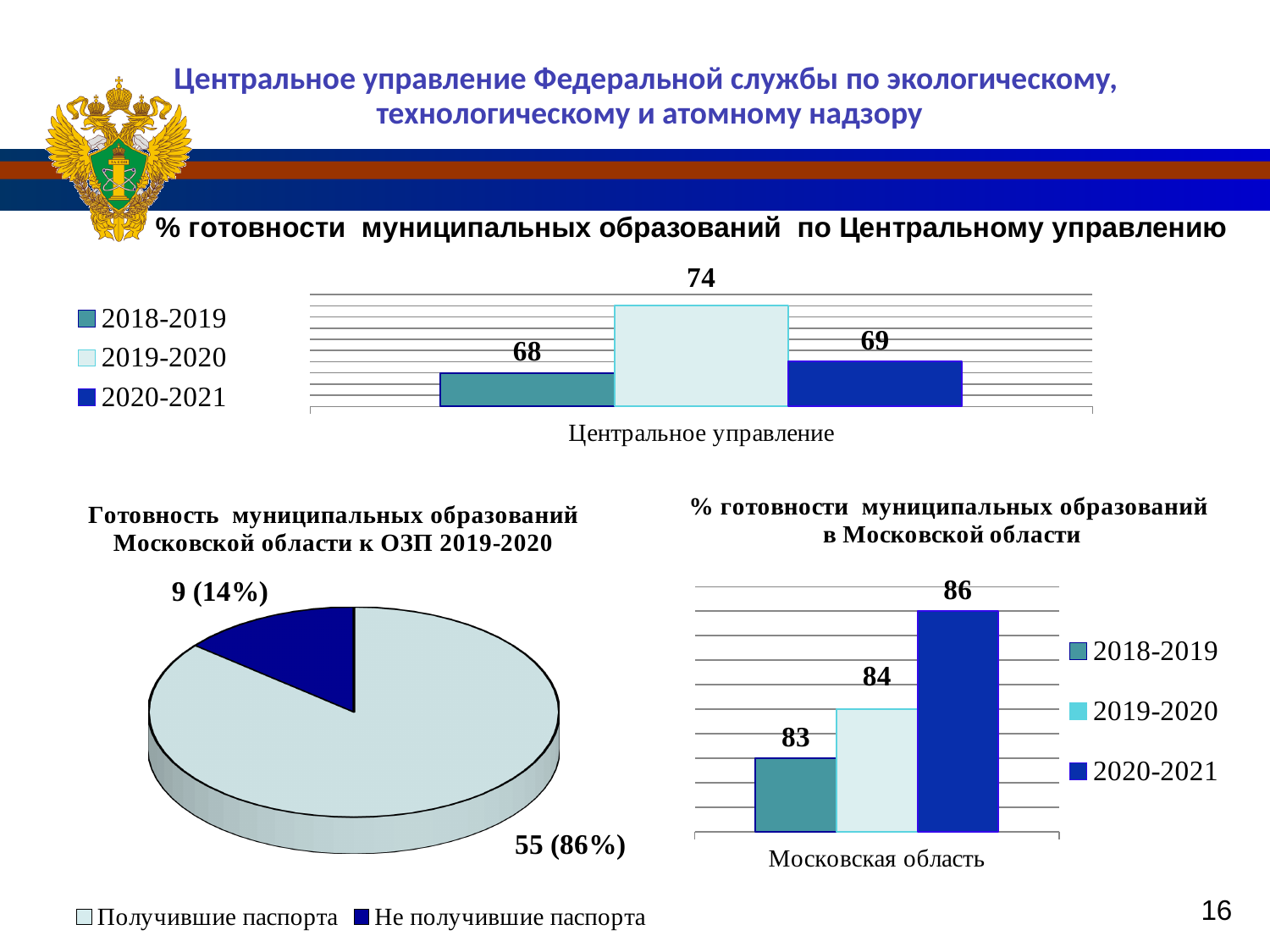
In the bottom-left pie chart 'Готовность муниципальных образований Московской области к ОЗП 2019-2020', what share of the pie is 'Не получившие паспорта'? 14% In the top chart '% готовности муниципальных образований по Центральному управлению', which series has the highest value? 2019-2020 In the bottom-right chart '% готовности муниципальных образований в Московской области', what is the difference between the 2020-2021 and 2018-2019 values? 3 In the top chart '% готовности муниципальных образований по Центральному управлению', how many series does the legend list? 3 In the top chart '% готовности муниципальных образований по Центральному управлению', what is the difference between the 2019-2020 and 2020-2021 values? 5 In the bottom-right chart '% готовности муниципальных образований в Московской области', which series has the lowest value? 2018-2019 In the bottom-right chart '% готовности муниципальных образований в Московской области', what is the value for 2020-2021? 86 In the bottom-right chart '% готовности муниципальных образований в Московской области', do the values rise or fall from 2018-2019 to 2020-2021? rise In the bottom-left pie chart 'Готовность муниципальных образований Московской области к ОЗП 2019-2020', what is the value for 'Получившие паспорта'? 55 (86%) What kind of chart is the bottom-left chart 'Готовность муниципальных образований Московской области к ОЗП 2019-2020'? pie chart In the top chart '% готовности муниципальных образований по Центральному управлению', what is the value for 2018-2019? 68 In the top chart '% готовности муниципальных образований по Центральному управлению', what is the value for 2019-2020? 74